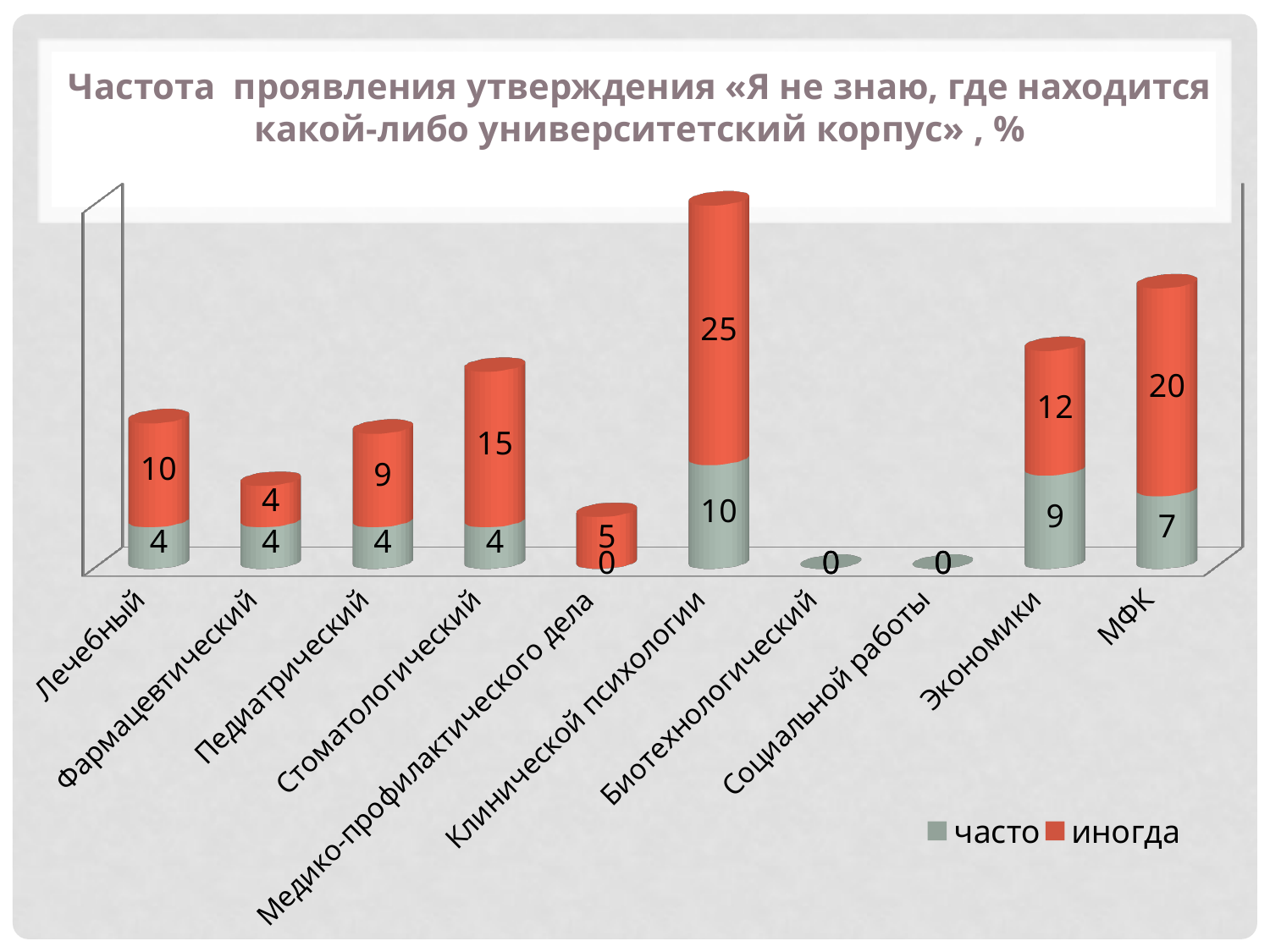
What is the value of "часто" for Медико-профилактического дела? 0 What is the value of "иногда" for Клинической психологии? 25 How many categories are shown on the x axis? 10 What is the total of the stacked bar for МФК? 27 What is the value of "часто" for Экономики? 9 What kind of chart is shown on the slide? bar chart What is the difference between the "иногда" values for МФК and Экономики? 8 What is the value of "иногда" for Стоматологический? 15 How many series does the legend list? 2 Which category has the highest "иногда" value? Клинической психологии Which series is shown in red in the legend? иногда Which is larger: the "часто" value for Клинической психологии or for МФК? Клинической психологии